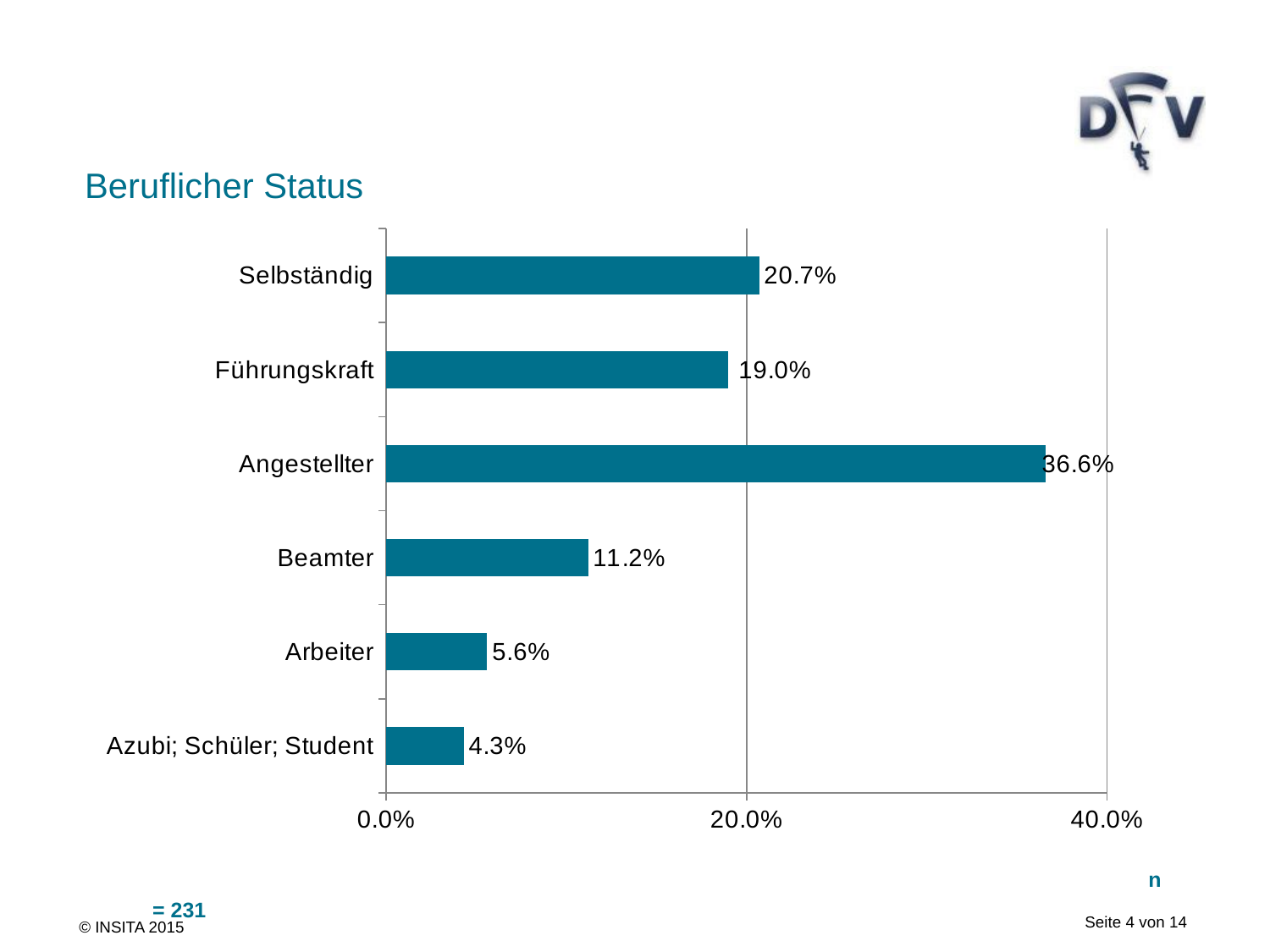
What is the value for Beamter? 11.2% Which category has the highest value? Angestellter What is the value for Azubi; Schüler; Student? 4.3% What is the title of the chart? Beruflicher Status What kind of chart is shown on the slide? bar chart How many categories are shown in the chart? 6 Which category has the lowest value? Azubi; Schüler; Student Which is larger, the value for Beamter or the value for Arbeiter? Beamter What is the difference between the values for Angestellter and Beamter? 25.4% Is the value for Selbständig greater or less than 20.0%? greater What is the value for Angestellter? 36.6% What is the difference between the values for Selbständig and Führungskraft? 1.7%